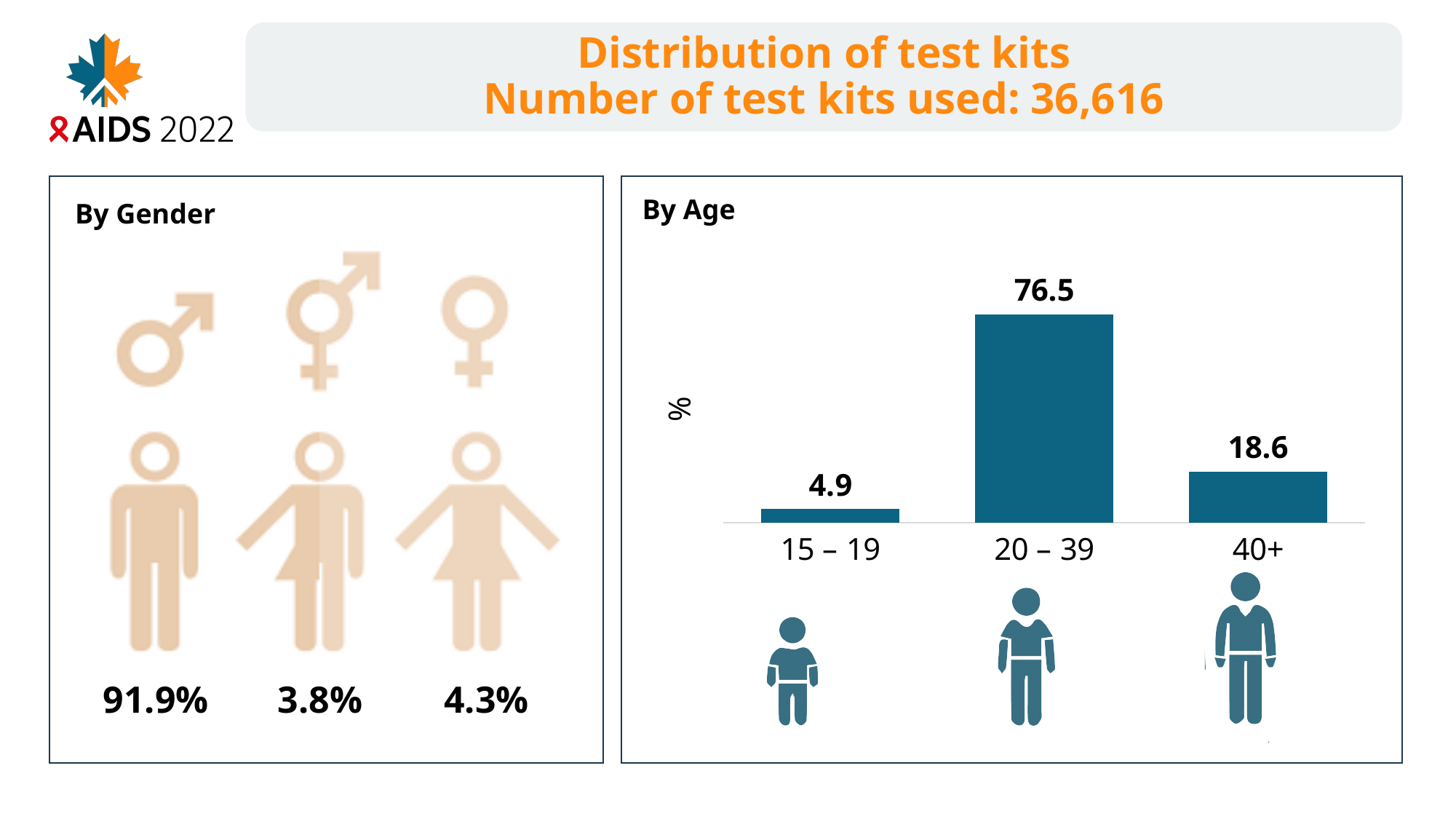
In the By Age chart, what is the value for the 15 – 19 age group? 4.9 In the By Age chart, which age group has the lowest value? 15 – 19 In the By Age chart, which is larger, the value for 40+ or the value for 15 – 19? 40+ In the By Gender panel, what is the largest percentage shown? 91.9% How many age groups are shown in the By Age chart? 3 In the By Age chart, what is the difference between the values for 40+ and 15 – 19? 13.7 In the By Age chart, what is the difference between the values for 20 – 39 and 40+? 57.9 What kind of chart is the By Age chart? bar chart In the By Age chart, what is the value for the 40+ age group? 18.6 In the By Age chart, which age group has the highest value? 20 – 39 In the By Age chart, what is the value for the 20 – 39 age group? 76.5 What is the label on the vertical axis of the By Age chart? %